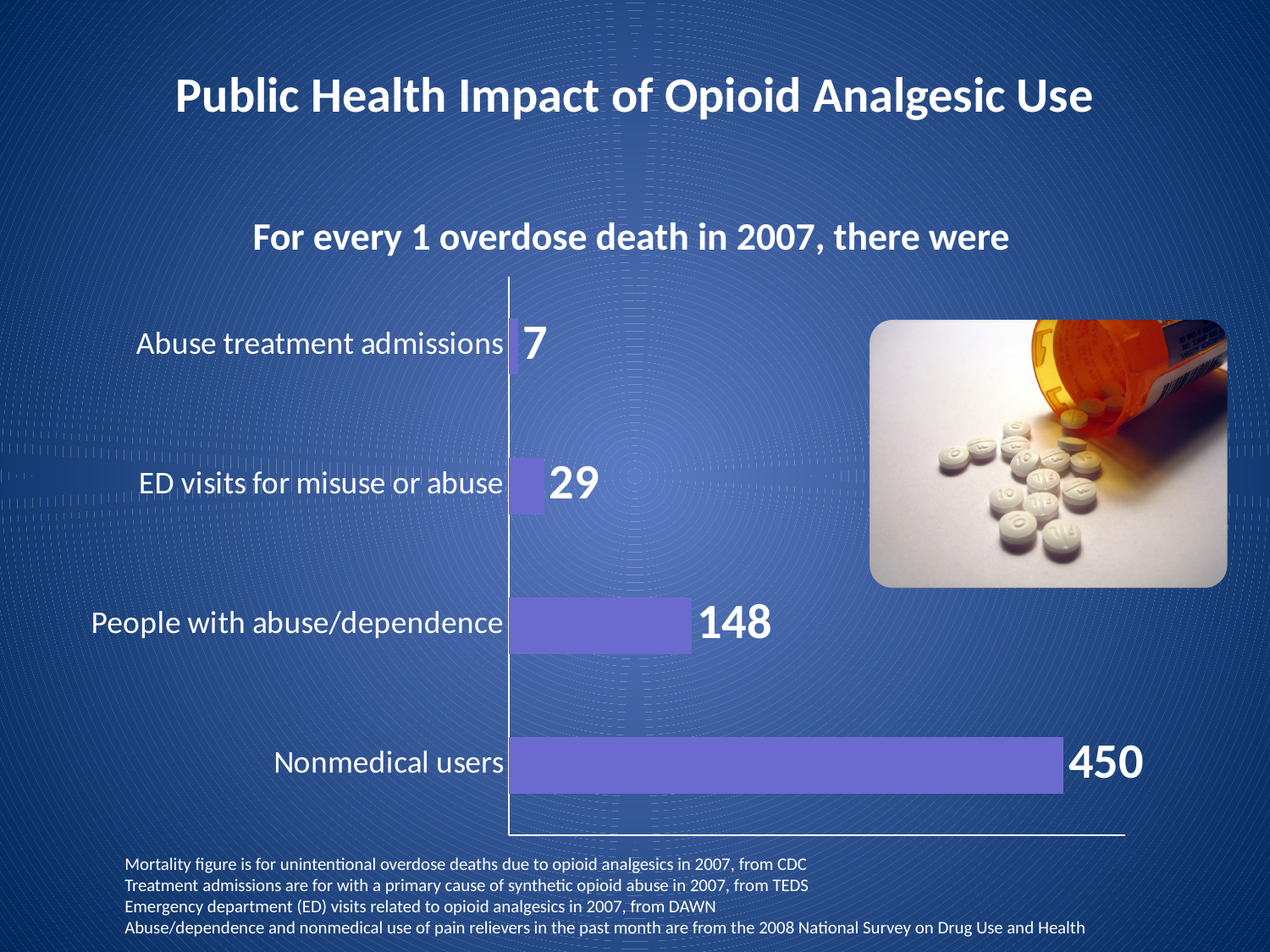
What is the value for Nonmedical users? 450 What is the title of the slide? Public Health Impact of Opioid Analgesic Use What kind of chart is shown on the slide? Bar chart What is the value for ED visits for misuse or abuse? 29 What is the difference between the values for ED visits for misuse or abuse and Abuse treatment admissions? 22 What is the value for Abuse treatment admissions? 7 Which category has the lowest value? Abuse treatment admissions What is the value for People with abuse/dependence? 148 Which is larger, the value for ED visits for misuse or abuse or the value for People with abuse/dependence? People with abuse/dependence What is the difference between the values for Nonmedical users and People with abuse/dependence? 302 Which category has the highest value? Nonmedical users How many categories are shown in the chart? 4